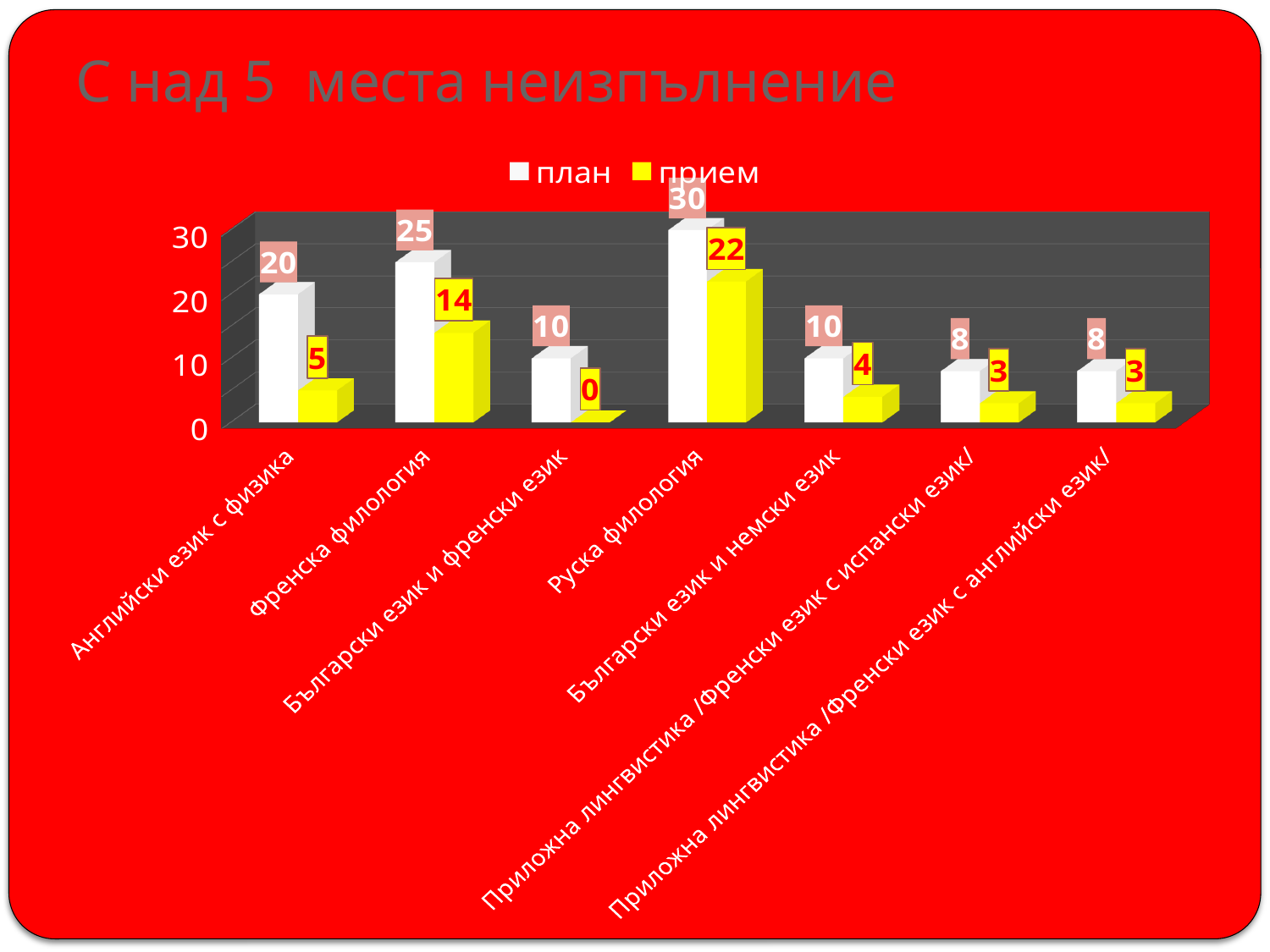
Which category has the lowest прием value? Български език и френски език What is the план value for Руска филология? 30 Which is larger: the прием value for Френска филология or the прием value for Руска филология? Руска филология What is the прием value for Френска филология? 14 What kind of chart is shown on the slide? bar chart What is the difference between план and прием for Английски език с физика? 15 What is the title of the slide? С над 5 места неизпълнение Which category has the highest план value? Руска филология What is the прием value for Български език и френски език? 0 How many series does the legend list? 2 How many categories are shown on the x axis? 7 What colour are the прием bars? yellow